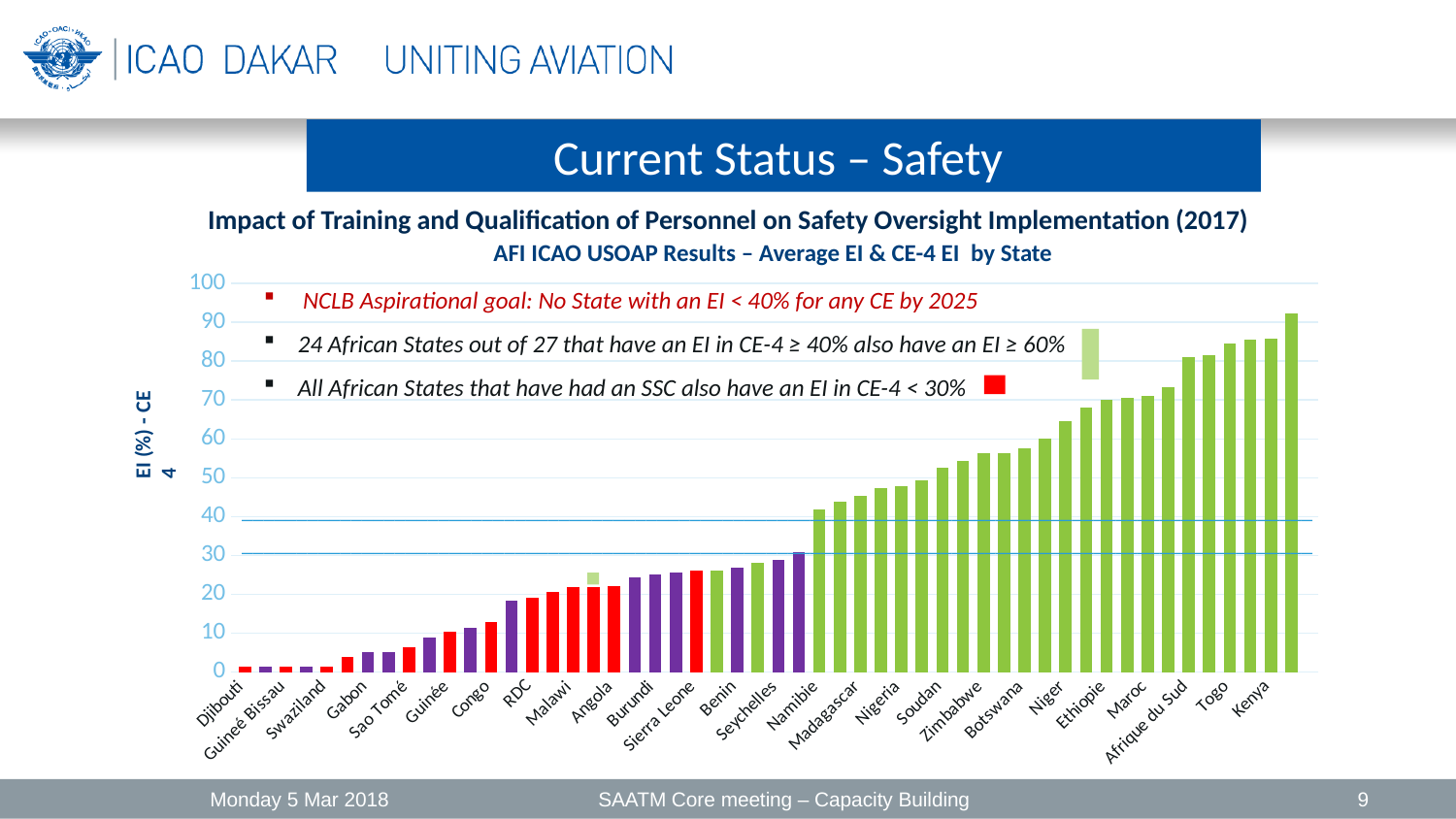
Is the value for Niger greater or less than 60? greater Do the values rise or fall moving from left to right along the x axis? rise Is the value for Benin greater or less than 30? less Is the value for Togo greater or less than 80? greater What kind of chart is shown on the slide? bar chart What is the label on the vertical axis of the chart? EI (%) - CE 4 Which has a higher value, Togo or Benin? Togo